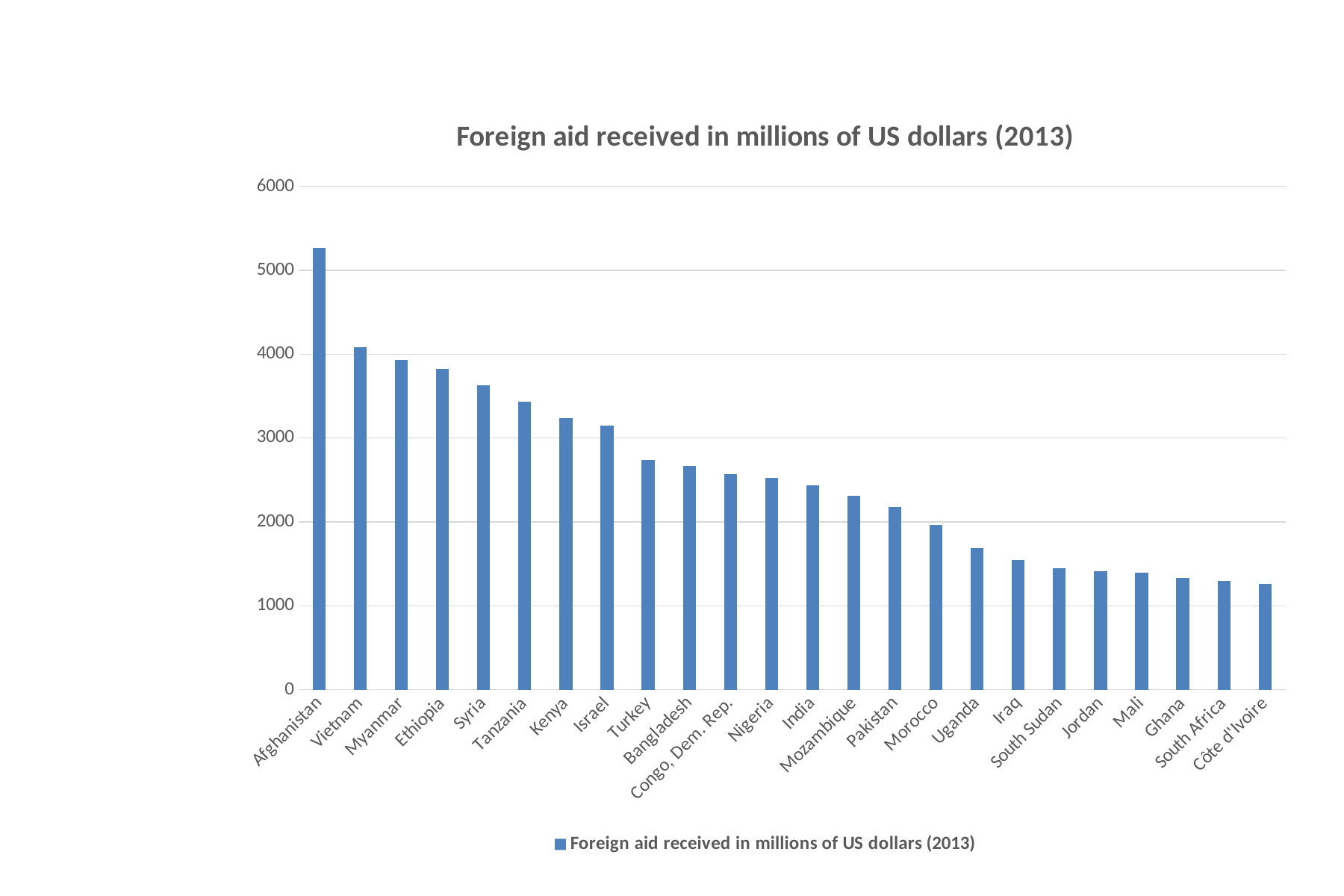
Is the value for Afghanistan greater or less than 5000? greater Is the value for Côte d'Ivoire greater or less than 1000? greater How many series does the legend list? 1 Do the values rise or fall moving from left to right along the x axis? fall What kind of chart is shown on the slide? bar chart Which country received the least foreign aid in 2013 according to the chart? Côte d'Ivoire Which country received the most foreign aid in 2013 according to the chart? Afghanistan How many countries are shown on the chart? 24 Which received more foreign aid, Kenya or Turkey? Kenya Is the value for Syria greater or less than 3000? greater